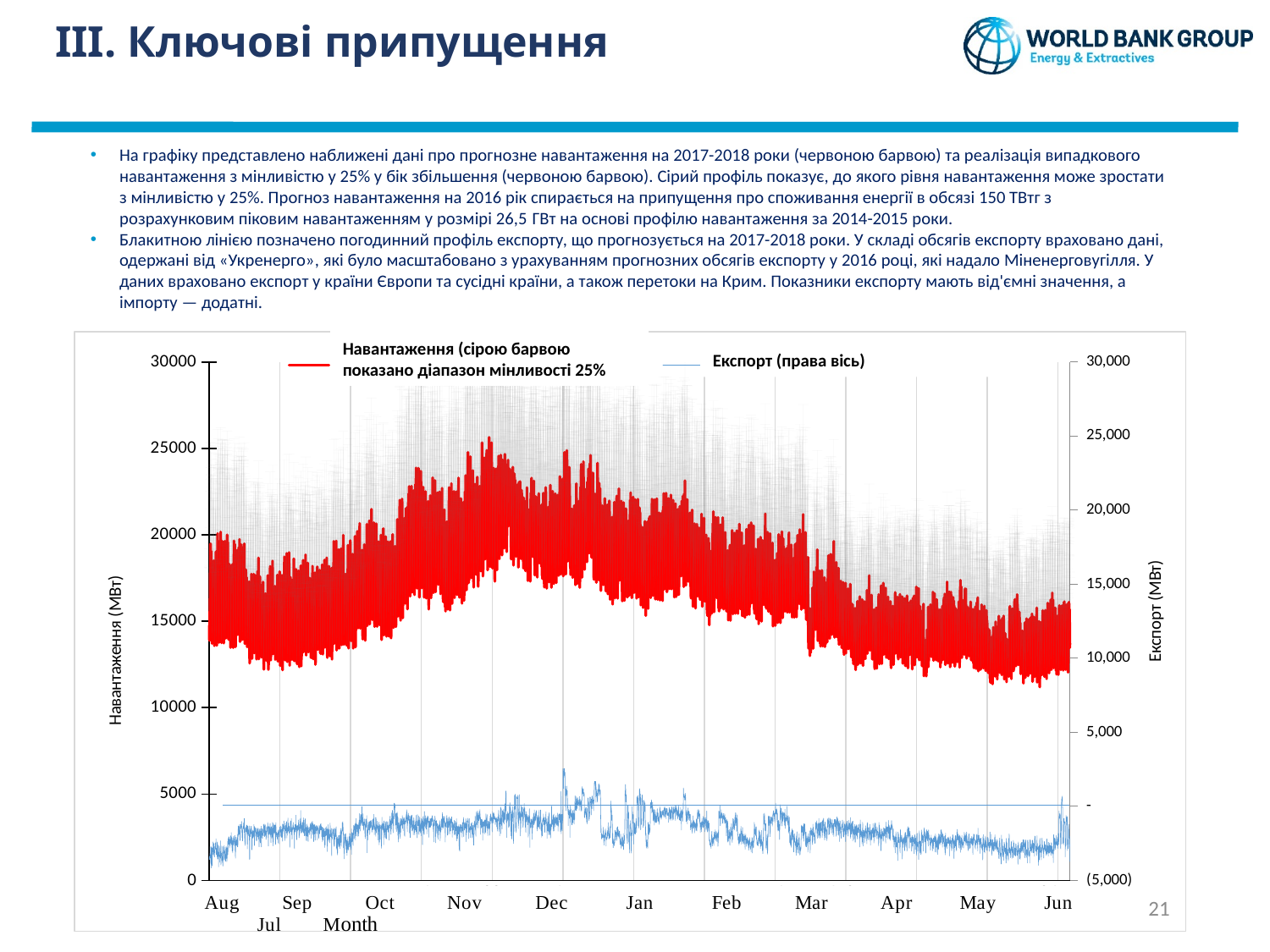
Is the peak of the red load series in Nov greater or less than 20000 on the left axis? greater Is the red load series in Aug greater or less than 10000 on the left axis? greater What is the highest tick value shown on the left vertical axis? 30000 What is the title of the right vertical axis of the chart? Експорт (МВт) Which is higher on the chart, the red load series in Nov or in Jun? Nov What is the title of the left vertical axis of the chart? Навантаження (МВт) How many series does the chart legend list? 2 Does the red load series rise or fall from Dec to Jun? fall Does the red load series rise or fall from Sep to Nov? rise What kind of chart is shown on the slide? line chart Is the blue export series in Dec greater or less than 5,000 on the right axis? less